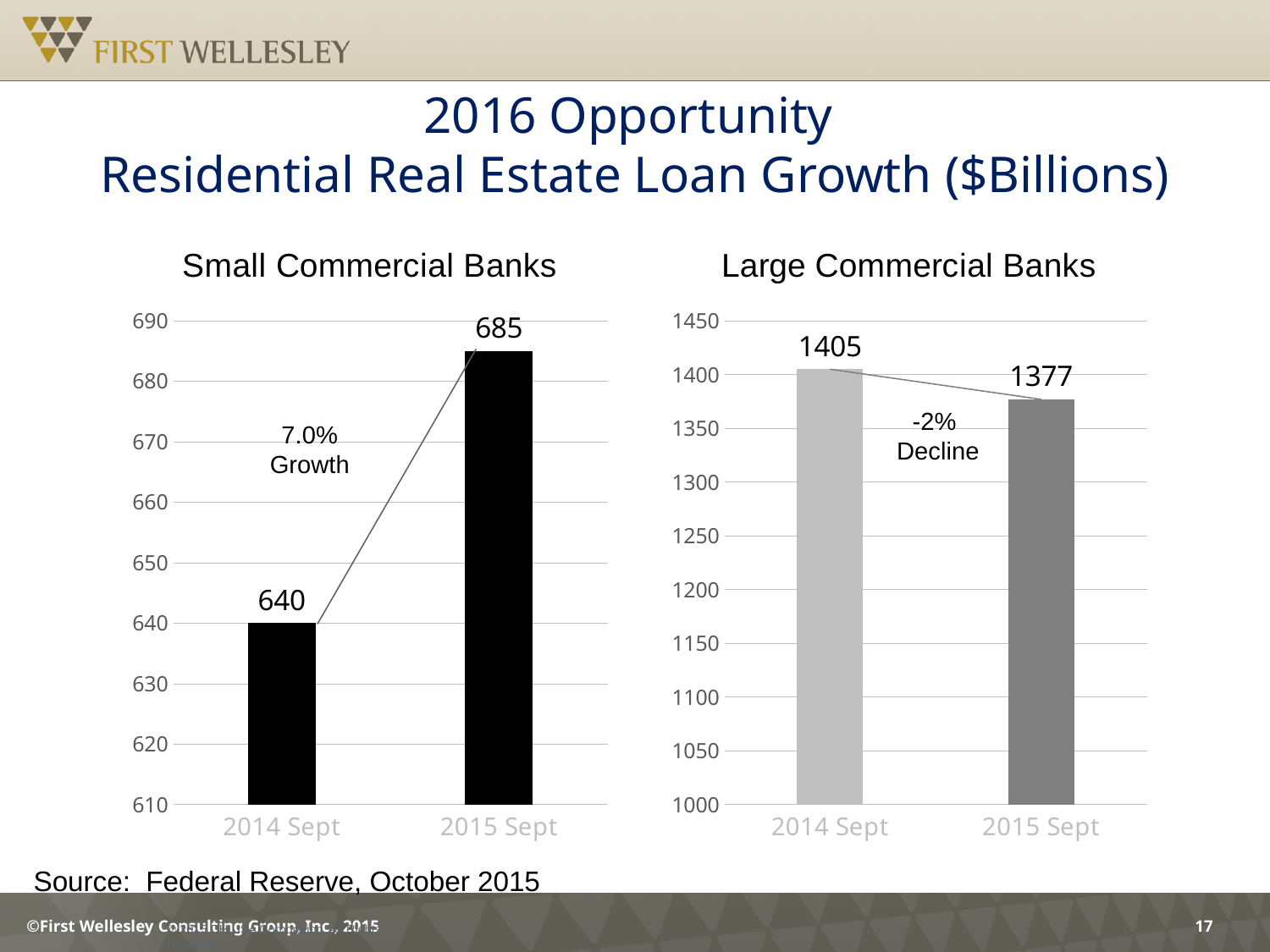
In the Small Commercial Banks chart, which period has the lowest value? 2014 Sept In the Large Commercial Banks chart, what is the difference between the 2014 Sept and 2015 Sept values? 28 In the Large Commercial Banks chart, what is the value for 2015 Sept? 1377 In the Large Commercial Banks chart, do values rise or fall from 2014 Sept to 2015 Sept? fall In the Small Commercial Banks chart, do values rise or fall from 2014 Sept to 2015 Sept? rise What kind of chart is the Small Commercial Banks chart? bar chart In the Small Commercial Banks chart, what is the value for 2014 Sept? 640 In the Small Commercial Banks chart, what is the value for 2015 Sept? 685 How many categories are shown on the x axis of the Large Commercial Banks chart? 2 In the Small Commercial Banks chart, what is the difference between the 2015 Sept and 2014 Sept values? 45 In the Large Commercial Banks chart, what is the value for 2014 Sept? 1405 In the Large Commercial Banks chart, which period has the higher value, 2014 Sept or 2015 Sept? 2014 Sept